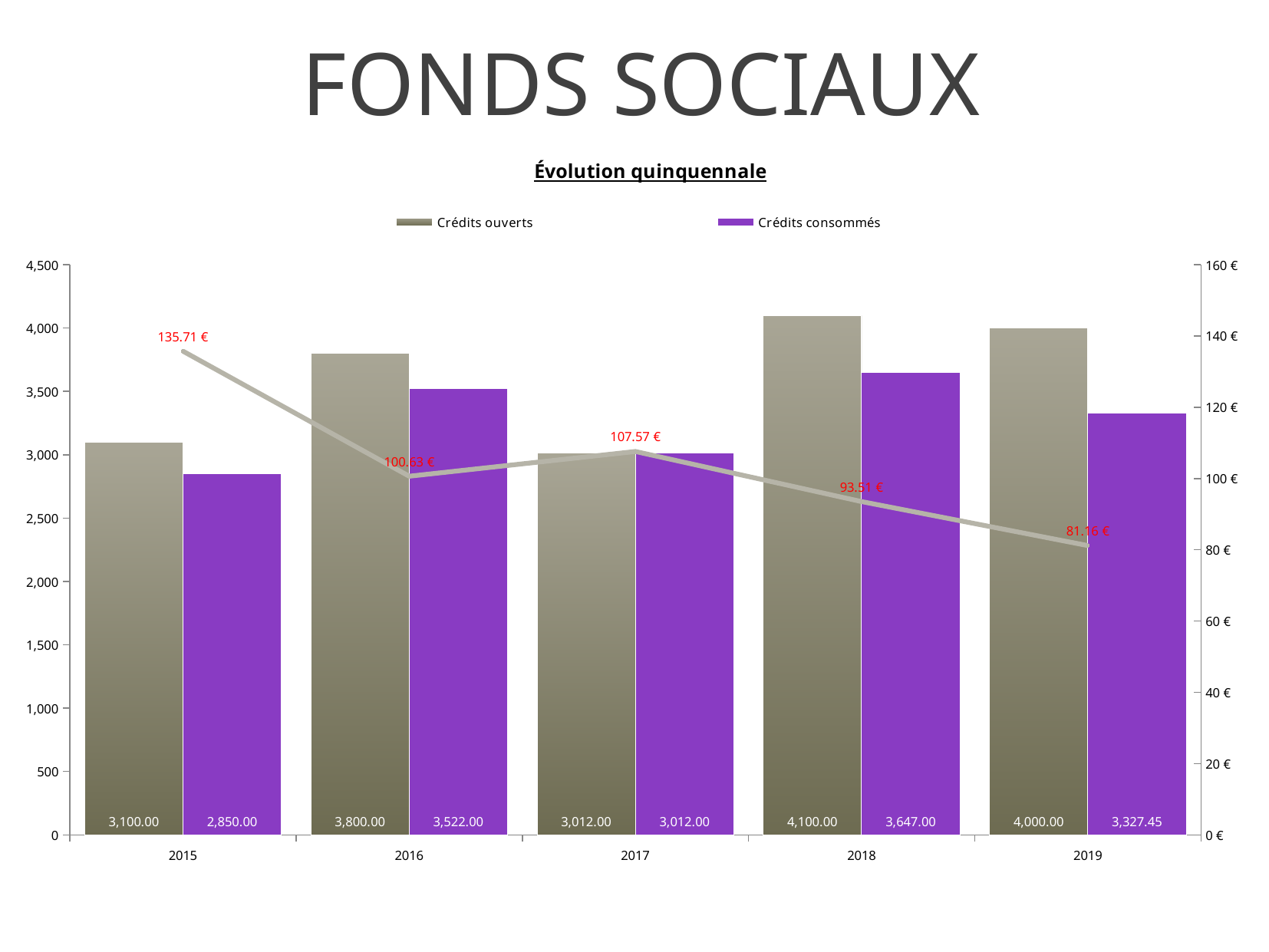
What is the difference between Crédits ouverts and Crédits consommés in 2018? 453.00 Which year has the lowest value for Crédits consommés? 2015 Which year has the highest value for Crédits ouverts? 2018 How many series does the legend list? 2 What is the value of Crédits consommés for 2019? 3,327.45 Which is larger in 2016, Crédits ouverts or Crédits consommés? Crédits ouverts What is the subtitle of the chart? Évolution quinquennale What is the value of Crédits consommés for 2015? 2,850.00 What is the value of the line series label shown for 2015? 135.71 € How many years are shown on the x axis? 5 What kind of chart is shown on the slide? Bar chart with a line What is the value of Crédits ouverts for 2018? 4,100.00